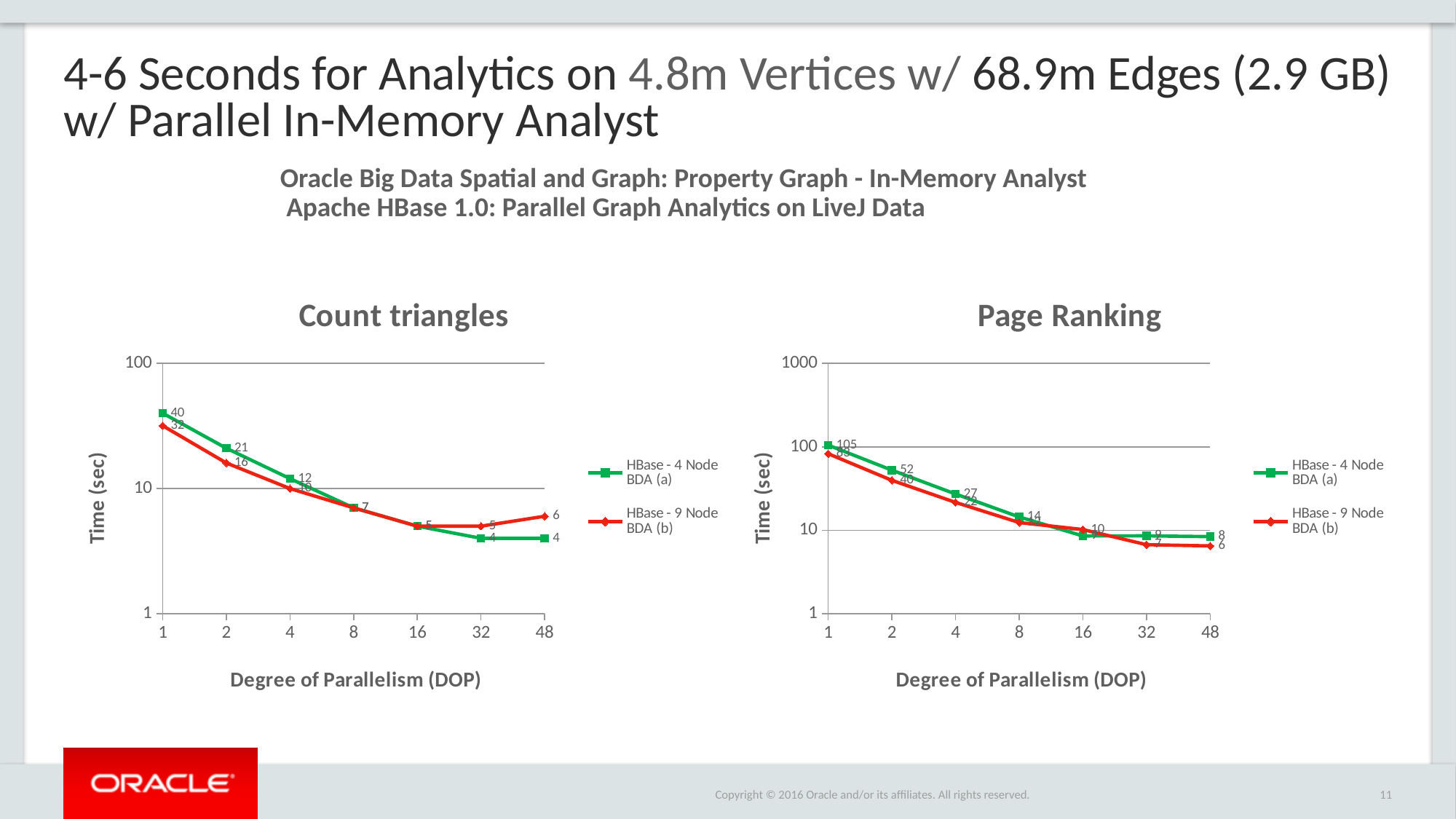
In the Page Ranking chart, does the time for HBase - 4 Node BDA (a) rise or fall as the Degree of Parallelism increases? fall In the Page Ranking chart, what is the time for HBase - 4 Node BDA (a) at DOP 1? 105 How many Degree of Parallelism values are plotted on the x axis of the Count triangles chart? 7 In the Count triangles chart, what is the time for HBase - 9 Node BDA (b) at DOP 2? 16 In the Page Ranking chart, what is the time for HBase - 9 Node BDA (b) at DOP 48? 6 How many series does the legend of the Page Ranking chart list? 2 In the Count triangles chart, what is the time for HBase - 4 Node BDA (a) at DOP 1? 40 What kind of chart is the Page Ranking chart? line chart In the Count triangles chart, what is the difference between the 4 Node and 9 Node times at DOP 1? 8 In the Page Ranking chart, what is the difference between the 4 Node and 9 Node times at DOP 2? 12 In the Page Ranking chart, at which DOP is the time for HBase - 4 Node BDA (a) highest? 1 In the Count triangles chart, which series has the higher time at DOP 48? HBase - 9 Node BDA (b)